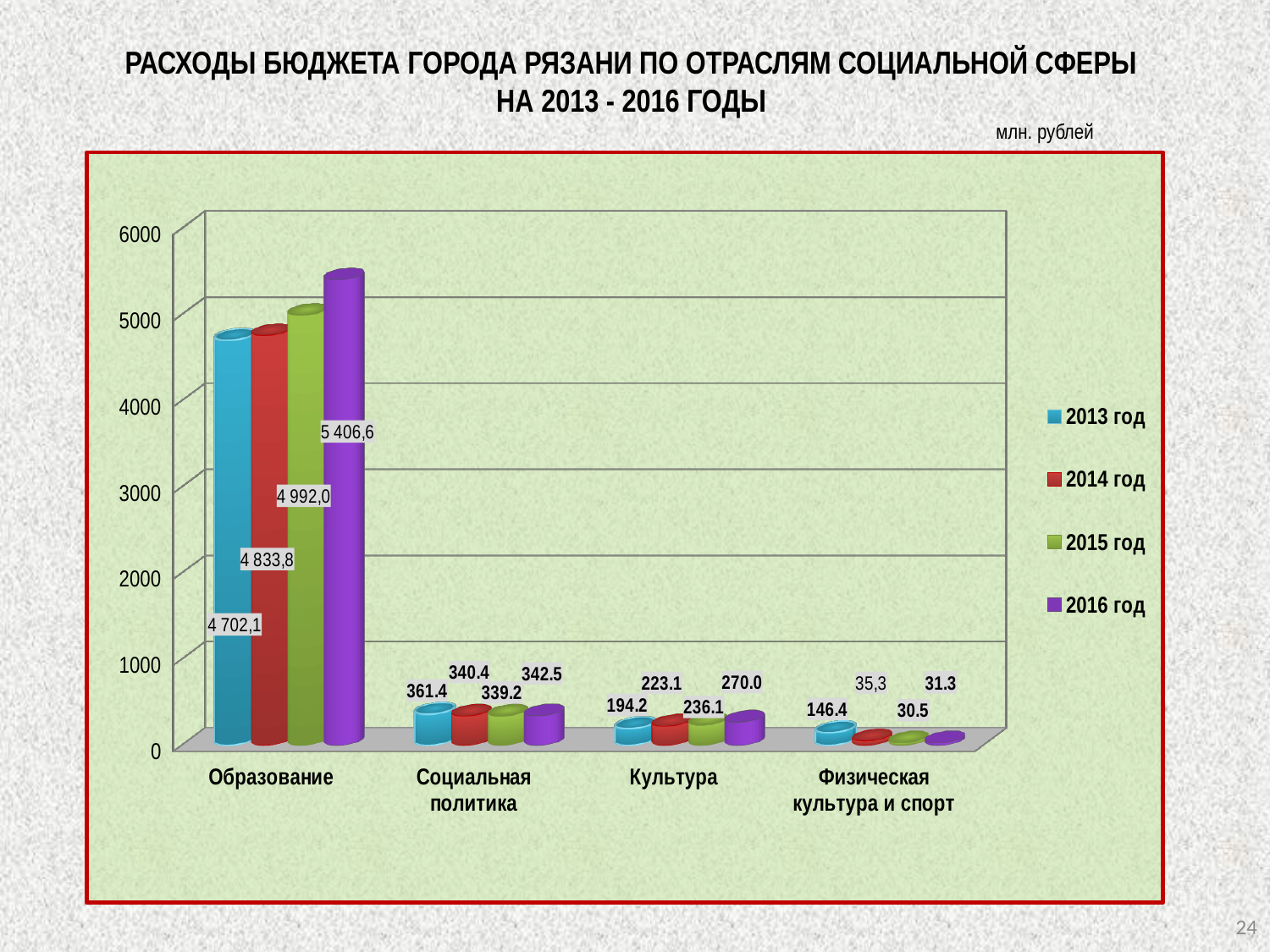
What kind of chart is shown on the slide? bar chart What is the value for Культура in 2015 год? 236.1 Which is larger for Культура: the 2013 год value or the 2014 год value? 2014 год What is the value for Социальная политика in 2013 год? 361.4 What is the value for Физическая культура и спорт in 2013 год? 146.4 Is the value for Образование in 2016 год greater or less than 5000? greater What is the value for Образование in 2016 год? 5 406,6 Which category has the lowest value in 2015 год? Физическая культура и спорт How many series does the legend list? 4 How many categories are shown on the x axis? 4 What is the difference between the 2016 год and 2013 год values for Образование? 704,5 Which category has the highest value in 2014 год? Образование